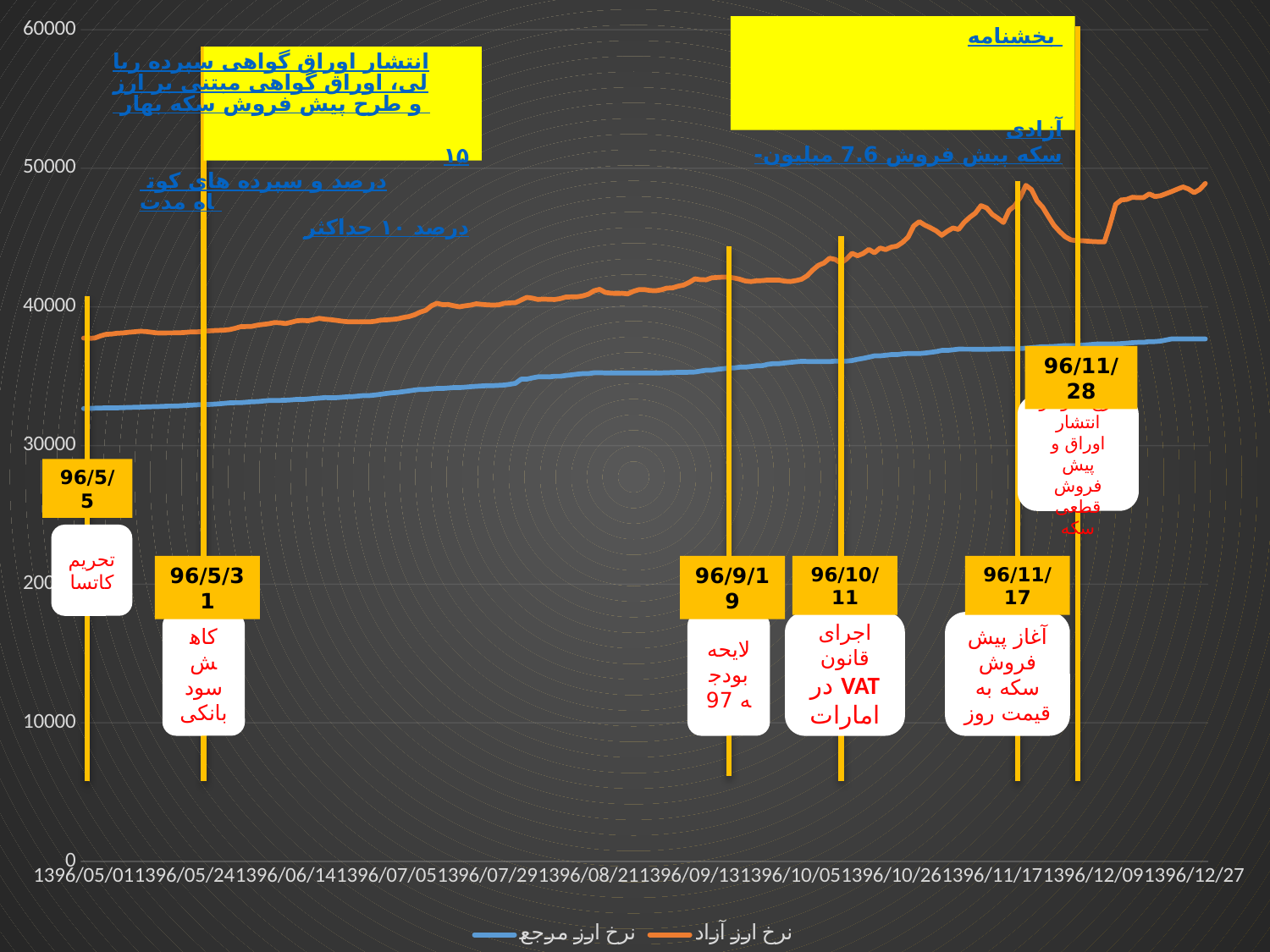
What kind of chart is shown on the slide? line chart Which series is drawn in orange according to the legend? نرخ ارز آزاد Which series is drawn in blue according to the legend? نرخ ارز مرجع Is the value for نرخ ارز آزاد at 1396/12/27 greater or less than 40000? greater Does the value of نرخ ارز مرجع rise or fall from 1396/05/01 to 1396/12/27? rise How many date labels are shown on the x axis? 12 Which series has the higher value at 1396/12/27, نرخ ارز آزاد or نرخ ارز مرجع? نرخ ارز آزاد Is the value for نرخ ارز مرجع at 1396/05/01 greater or less than 30000? greater Is the value for نرخ ارز مرجع at 1396/12/27 greater or less than 40000? less How many series does the legend list? 2 Does the value of نرخ ارز آزاد rise or fall from 1396/05/01 to 1396/12/27? rise